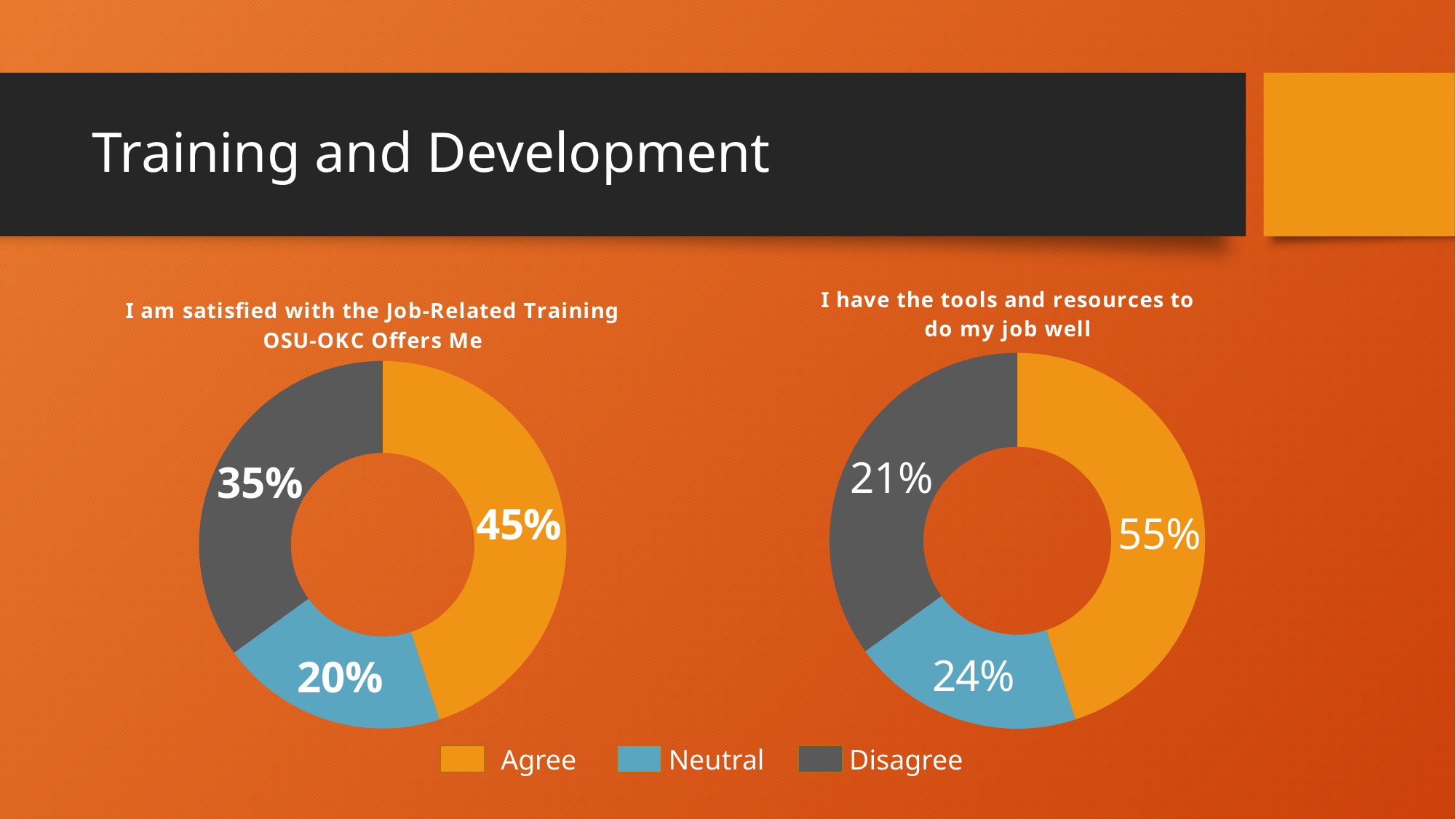
In the chart titled 'I have the tools and resources to do my job well', which response category has the smallest share? Disagree Which chart has the larger Disagree share: 'I am satisfied with the Job-Related Training OSU-OKC Offers Me' or 'I have the tools and resources to do my job well'? I am satisfied with the Job-Related Training OSU-OKC Offers Me In the chart titled 'I have the tools and resources to do my job well', what is the difference in percentage points between Agree and Neutral? 31 How many response categories does the legend list? 3 In the chart titled 'I have the tools and resources to do my job well', what percentage of respondents chose Agree? 55% What type of chart is used on the left side of the slide? Doughnut chart In the chart titled 'I am satisfied with the Job-Related Training OSU-OKC Offers Me', what percentage of respondents chose Neutral? 20% In the chart titled 'I have the tools and resources to do my job well', what percentage of respondents chose Disagree? 21% In the chart titled 'I am satisfied with the Job-Related Training OSU-OKC Offers Me', what percentage of respondents chose Agree? 45% In the chart titled 'I am satisfied with the Job-Related Training OSU-OKC Offers Me', which response category has the largest share? Agree Which colour represents Neutral in the legend? Blue In the chart titled 'I am satisfied with the Job-Related Training OSU-OKC Offers Me', what is the difference in percentage points between Agree and Disagree? 10